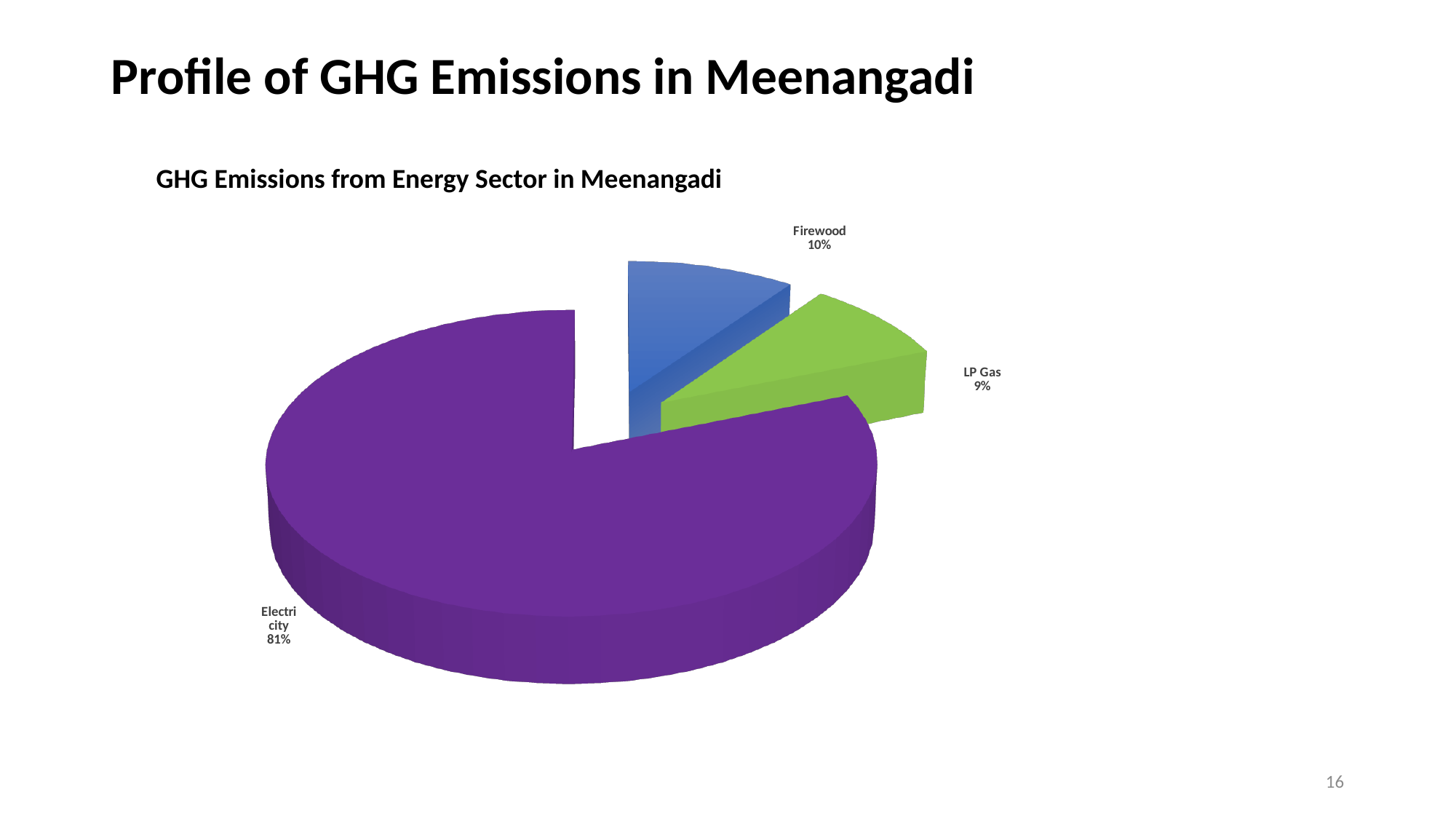
What share of GHG emissions from the energy sector comes from LP Gas? 9% What is the title of the chart? GHG Emissions from Energy Sector in Meenangadi What is the difference in percentage points between the Electricity share and the Firewood share? 71 What share of GHG emissions from the energy sector comes from Electricity? 81% Which source accounts for the largest share of energy-sector GHG emissions? Electricity Which has a larger share, Firewood or LP Gas? Firewood What type of chart is shown on the slide? Pie chart What is the difference in percentage points between the Firewood share and the LP Gas share? 1 How many emission sources are shown in the pie chart? 3 Which source accounts for the smallest share of energy-sector GHG emissions? LP Gas What colour is the Electricity slice of the pie chart? Purple What share of GHG emissions from the energy sector comes from Firewood? 10%